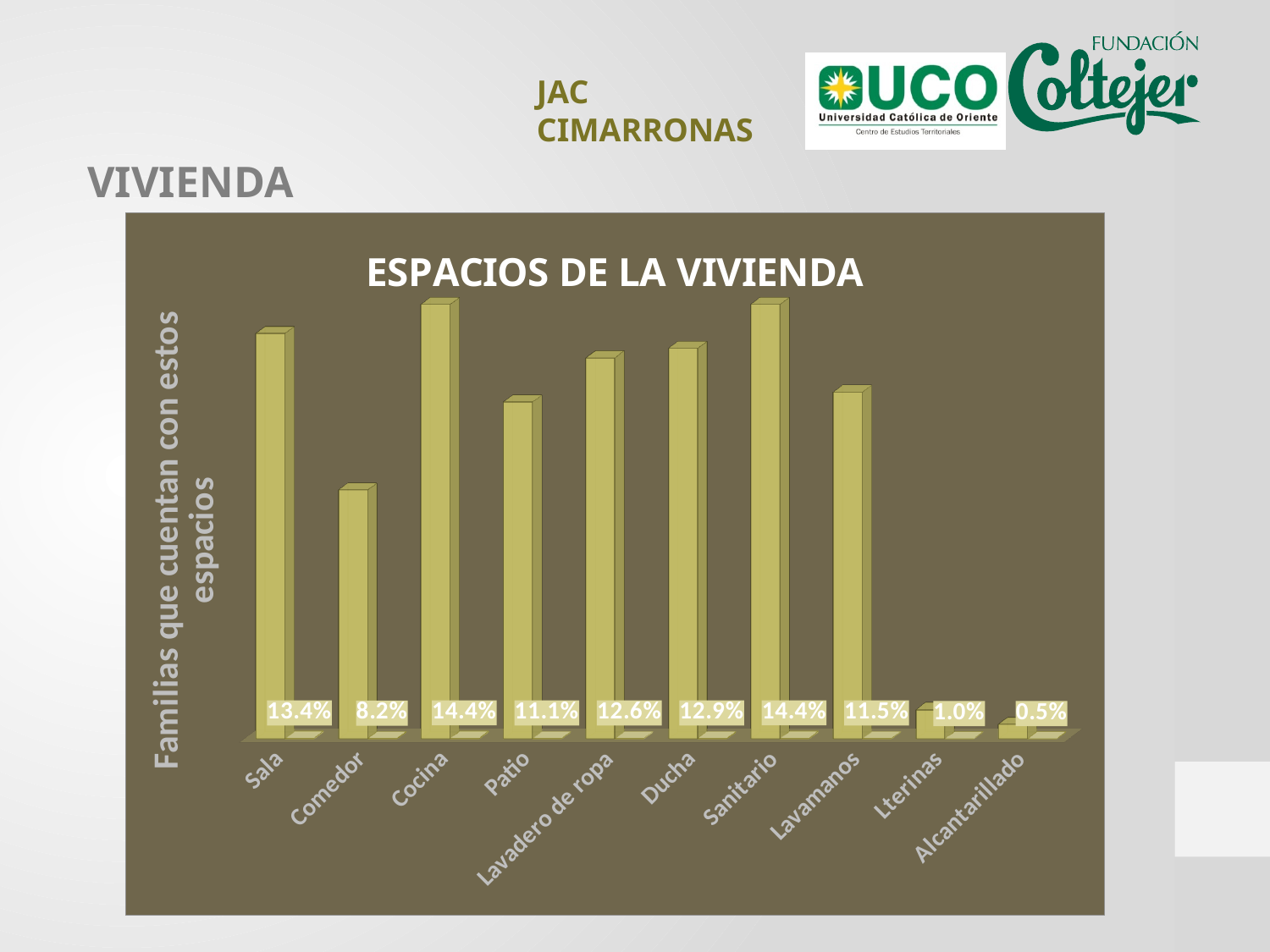
What is the difference between the values for Cocina and Comedor? 6.2% What is the difference between the values for Ducha and Patio? 1.8% How many categories are shown in the chart? 10 Which is larger, the value for Lterinas or the value for Alcantarillado? Lterinas What is the value for Lavamanos? 11.5% What is the value for Sala in the ESPACIOS DE LA VIVIENDA chart? 13.4% Which category has the lowest value? Alcantarillado What kind of chart is shown on the slide? Bar chart What is the title of the chart? ESPACIOS DE LA VIVIENDA What is the value for Lavadero de ropa? 12.6% What is the value for Comedor? 8.2% Which is larger, the value for Sala or the value for Lavamanos? Sala